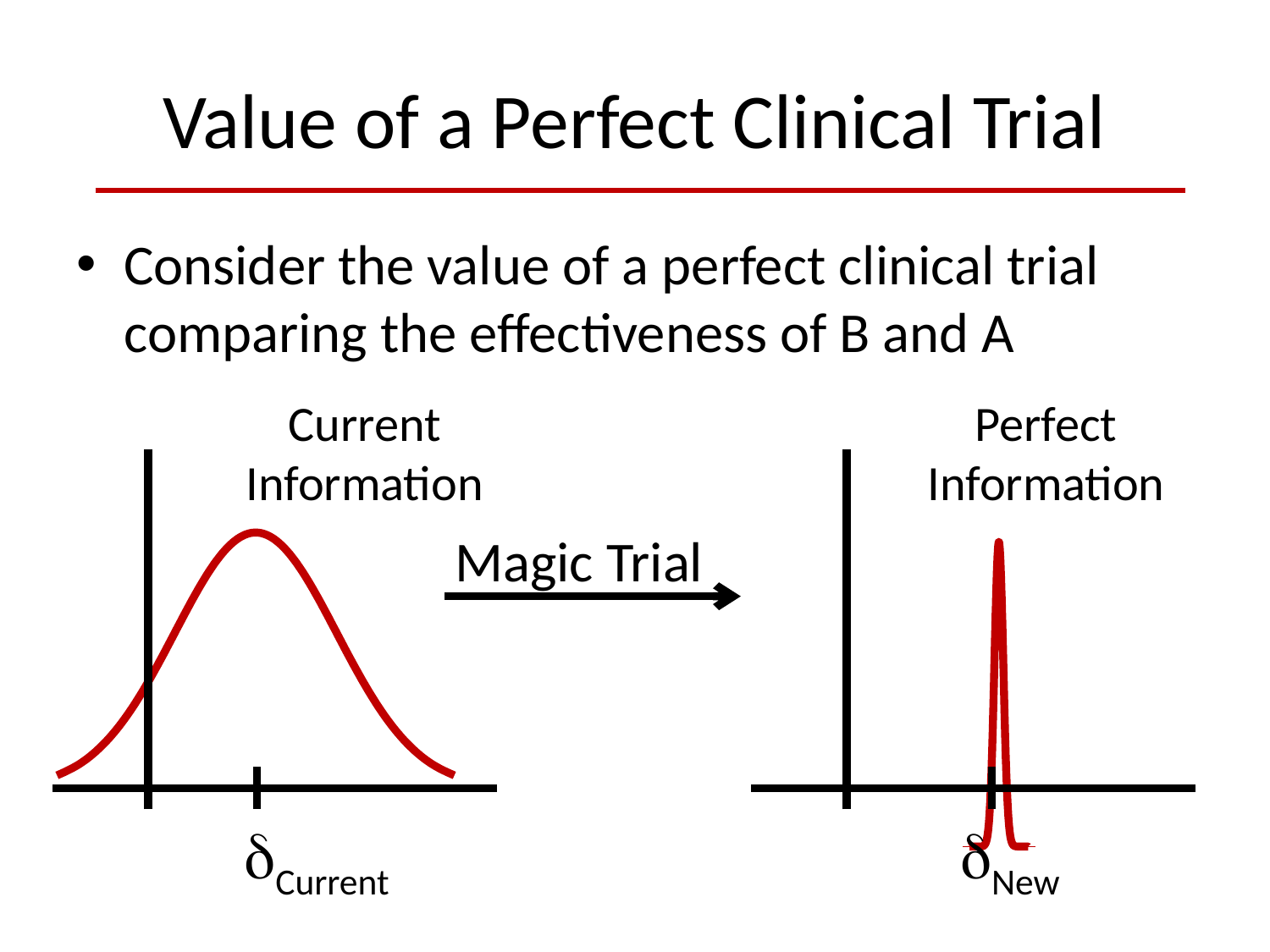
Which chart shows the narrower curve, 'Current Information' or 'Perfect Information'? Perfect Information What is the label under the x-axis tick of the 'Current Information' chart on the left? δCurrent What text is written above the arrow between the 'Current Information' and 'Perfect Information' charts? Magic Trial What kind of chart is used for the 'Current Information' diagram on the left? line chart